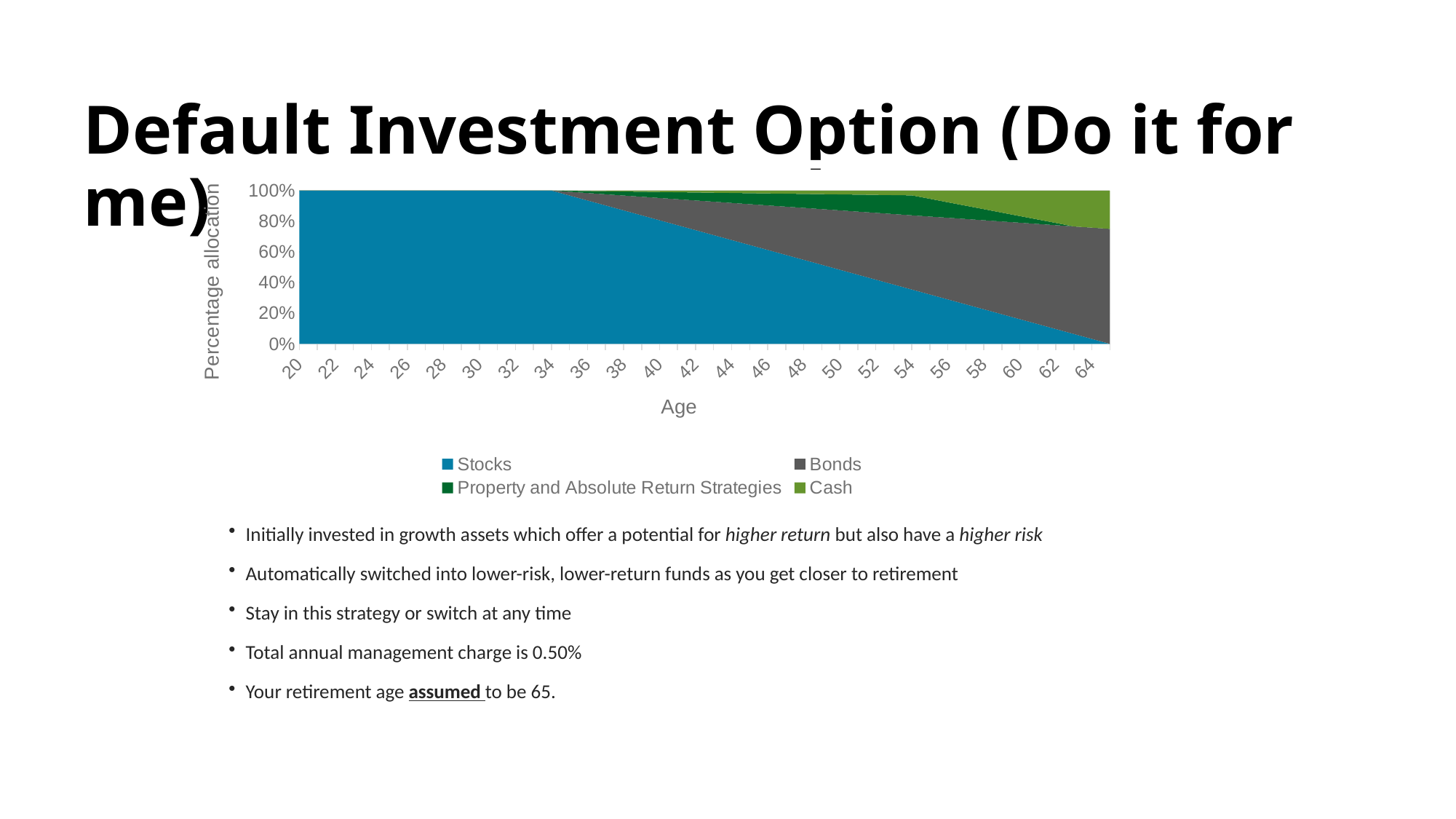
Does the Stocks allocation rise or fall as age increases along the x axis? Fall Does the Bonds allocation rise or fall as age increases along the x axis? Rise What is the Stocks allocation at age 20? 100% Is the Stocks allocation at age 60 greater or less than 40%? less How many series does the chart legend list? 4 Is the Stocks allocation at age 40 greater or less than 60%? greater Which series has the largest allocation at age 20? Stocks How many age labels are shown on the x axis? 23 What is the label of the chart's vertical axis? Percentage allocation What kind of chart is shown on the slide? Stacked area chart What are the four series listed in the chart legend? Stocks, Bonds, Property and Absolute Return Strategies, Cash At age 60, which is larger: the Bonds allocation or the Stocks allocation? Bonds